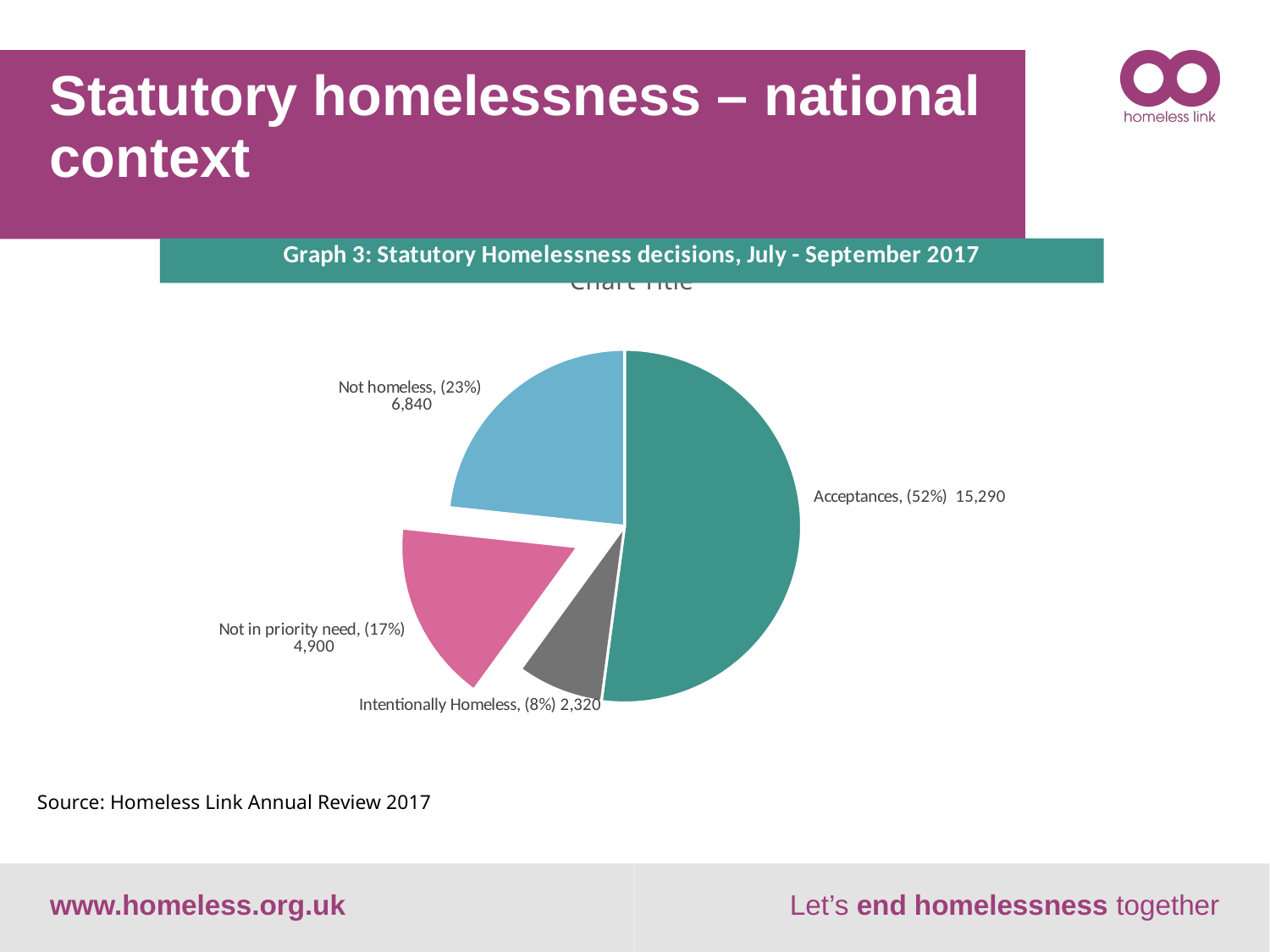
What is the value for Intentionally Homeless? 2,320 Which is larger, the value for Not homeless or the value for Intentionally Homeless? Not homeless What share of the pie does Acceptances represent? 52% Which category has the smallest slice of the pie? Intentionally Homeless What share of the pie does Not in priority need represent? 17% What is the value for Not homeless? 6,840 What is the difference between the values for Not homeless and Not in priority need? 1,940 Which category has the largest slice of the pie? Acceptances How many slices does the pie chart have? 4 What is the value for Not in priority need? 4,900 What kind of chart is shown on the slide? pie chart What is the value for Acceptances? 15,290